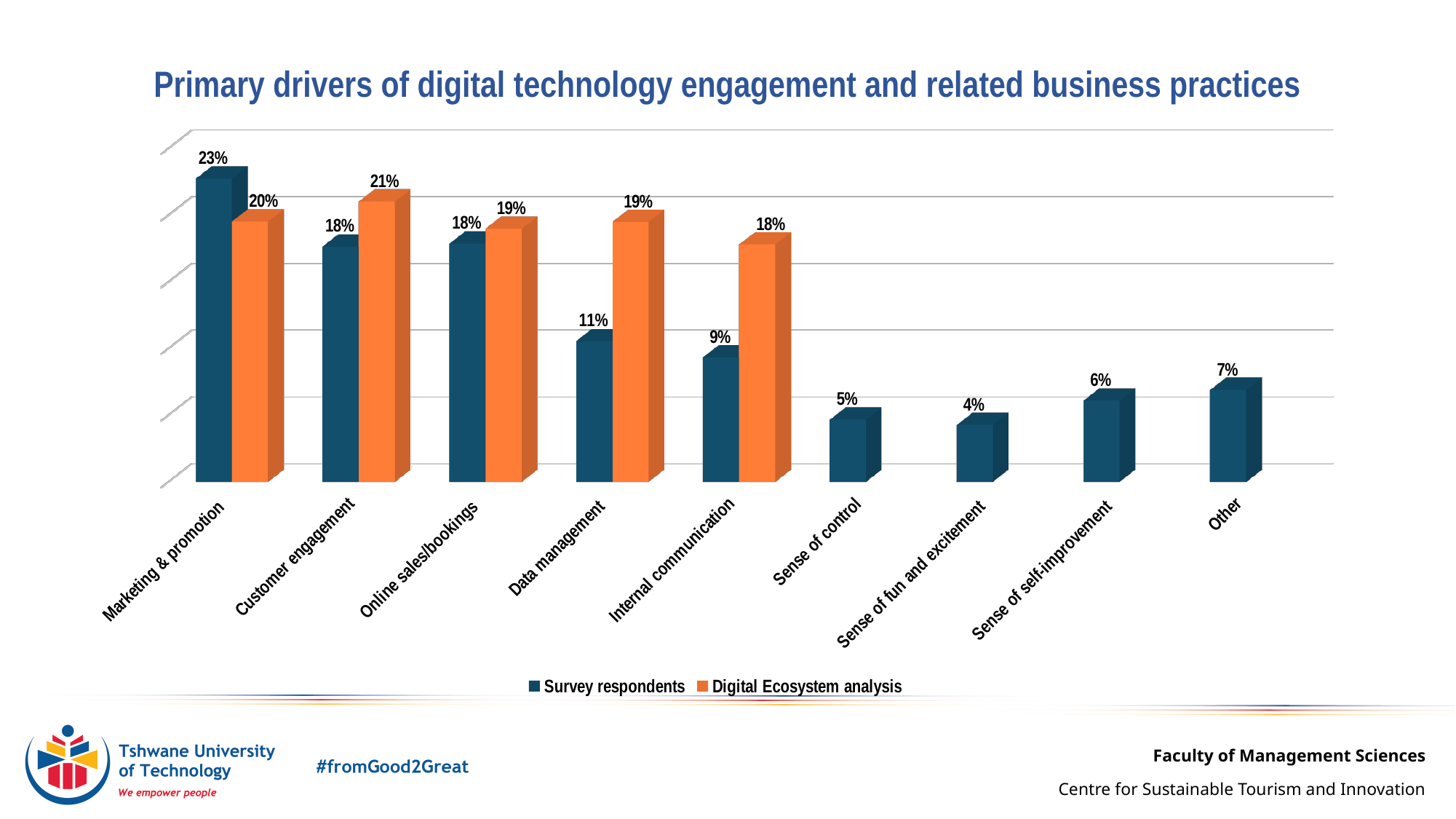
Which is larger for Data management: the Survey respondents value or the Digital Ecosystem analysis value? Digital Ecosystem analysis What is the Digital Ecosystem analysis value for Customer engagement? 21% What is the Digital Ecosystem analysis value for Data management? 19% What is the Survey respondents value for Marketing & promotion? 23% What is the title of the chart? Primary drivers of digital technology engagement and related business practices Which category has the lowest Survey respondents value? Sense of fun and excitement How many categories are shown on the x axis? 9 Which category has the highest Survey respondents value? Marketing & promotion What kind of chart is shown on the slide? Bar chart How many series does the legend list? 2 What is the difference between the Digital Ecosystem analysis value and the Survey respondents value for Internal communication? 9% What is the Survey respondents value for Internal communication? 9%